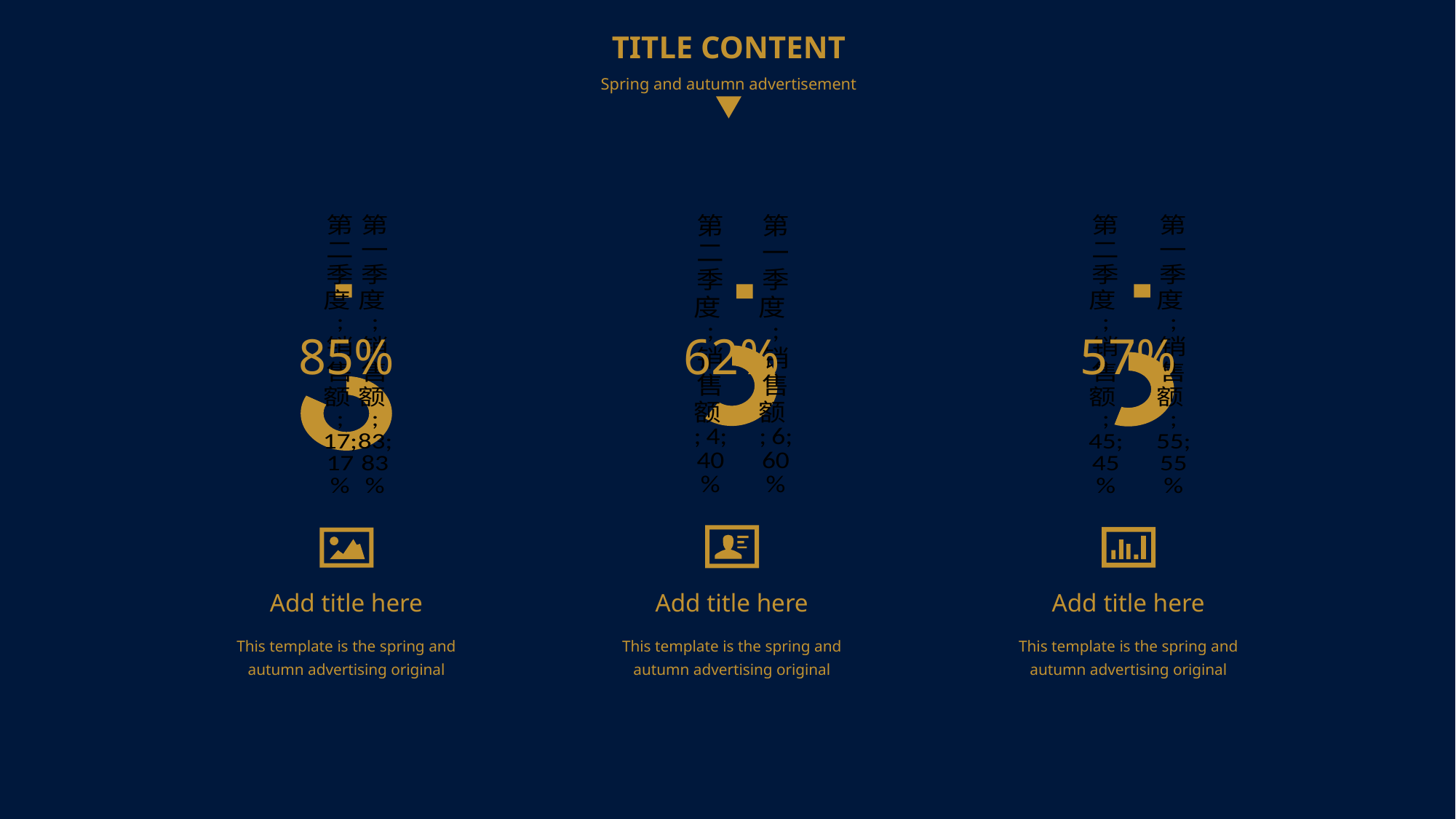
What kind of chart is the left chart on the slide? doughnut chart What large percentage is displayed over the right chart? 57% In the left chart, what share is labelled for 第一季度 (first quarter)? 83% In the middle chart, what share is labelled for 第二季度 (second quarter)? 40% What large percentage is displayed over the left chart? 85% How many charts are shown on the slide? 3 In the right chart, what share is labelled for 第一季度 (first quarter)? 55% Is the large percentage over the middle chart greater or less than the one over the right chart? greater Which of the three charts shows the highest large percentage? the left chart (85%) Which of the three charts shows the lowest large percentage? the right chart (57%) What is the difference between the large percentages shown over the left and right charts? 28% What large percentage is displayed over the middle chart? 62%